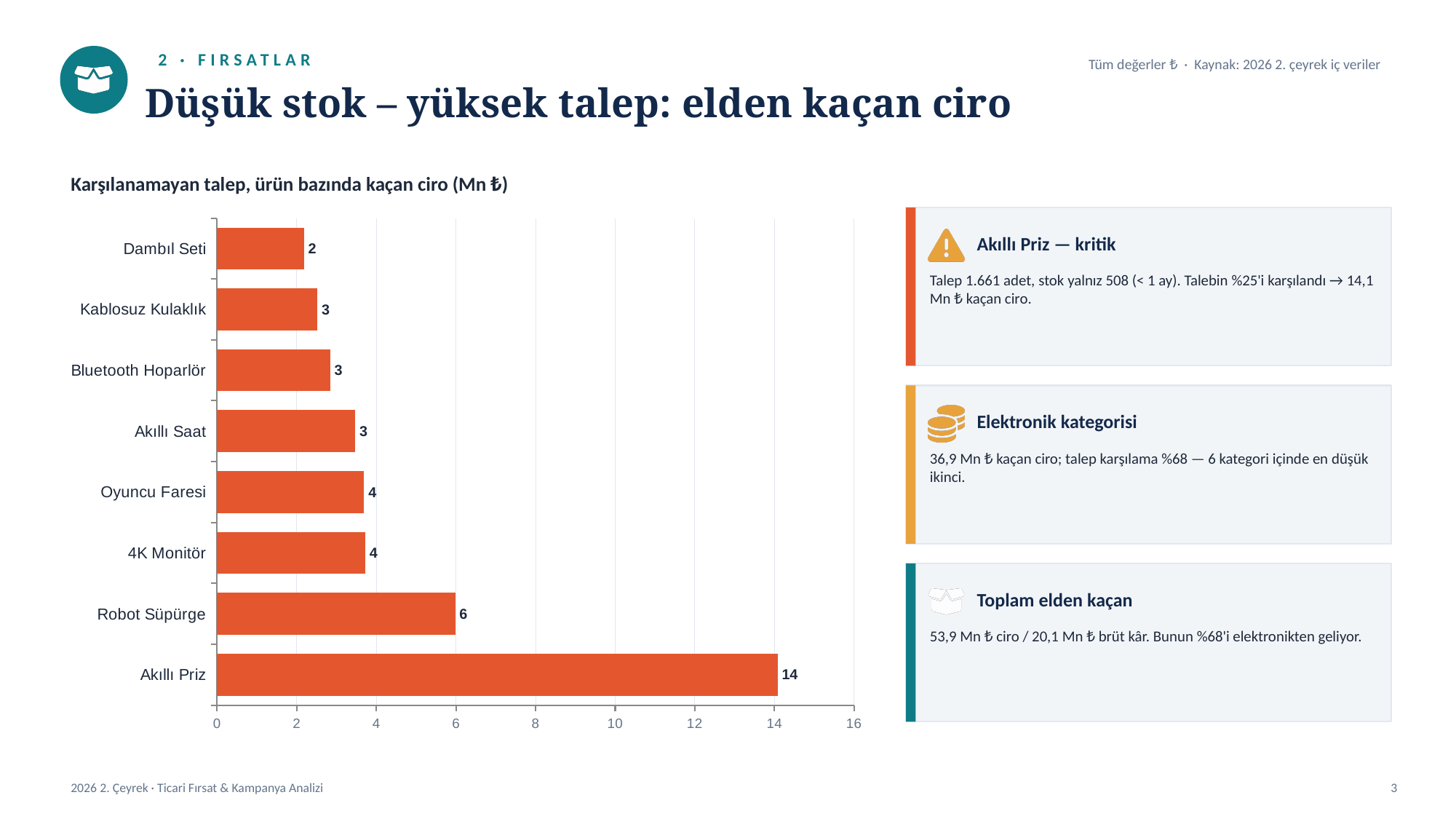
What is the value for Akıllı Priz? 14 Which product has the highest lost revenue? Akıllı Priz Which is larger, the value for Robot Süpürge or the value for 4K Monitör? Robot Süpürge What kind of chart is shown on the slide? bar chart Which product has the lowest lost revenue? Dambıl Seti What is the difference between the values for Akıllı Priz and Robot Süpürge? 8 What is the title of the chart? Karşılanamayan talep, ürün bazında kaçan ciro (Mn ₺) What is the value for Oyuncu Faresi? 4 What is the value for Dambıl Seti? 2 How many products are shown in the chart? 8 Is the value for Akıllı Priz greater or less than 12? greater What is the value for Robot Süpürge? 6